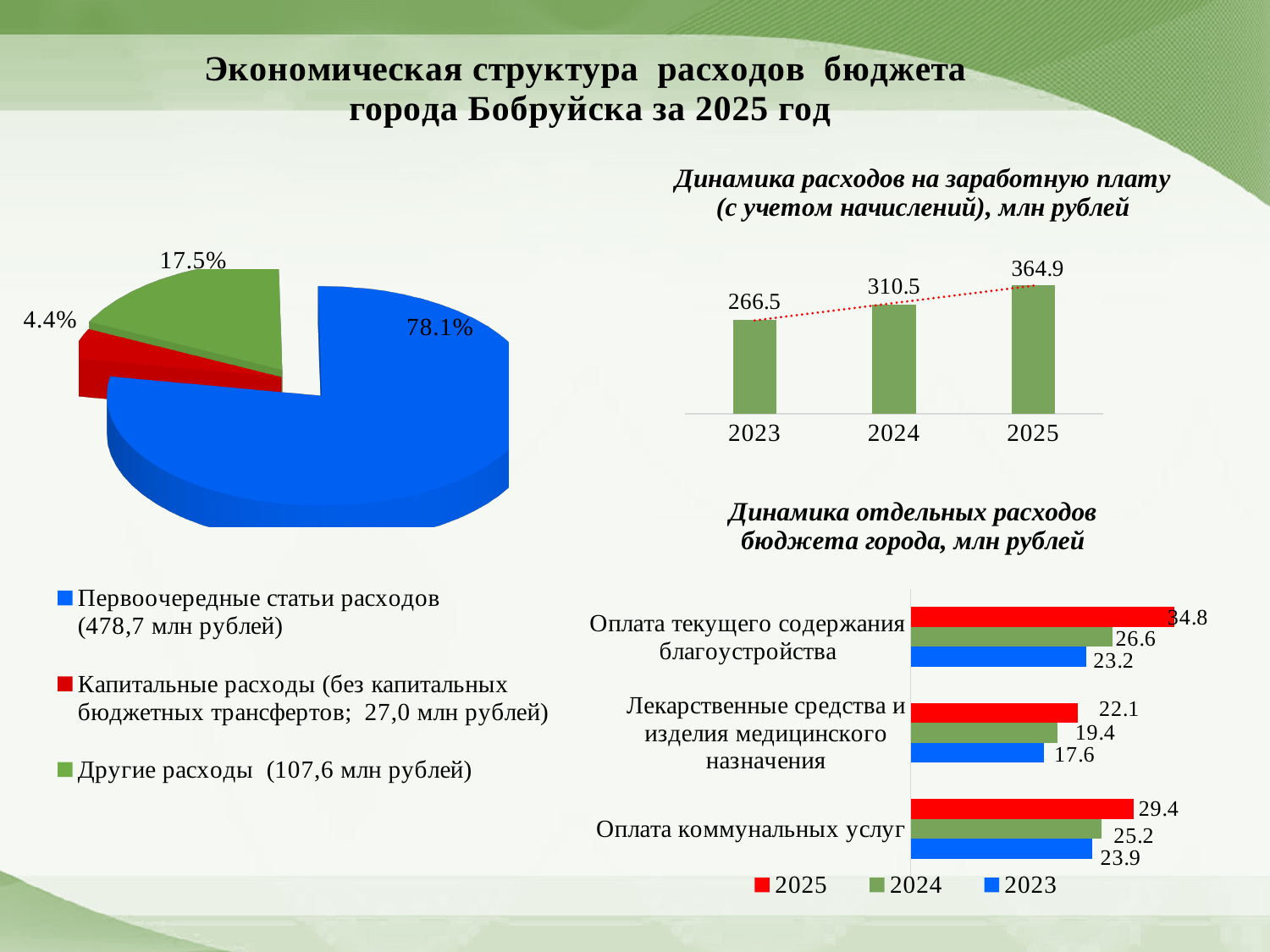
In the pie chart on the left, what share is shown for Первоочередные статьи расходов? 78.1% In the chart 'Динамика расходов на заработную плату', do the values rise or fall from 2023 to 2025? rise In the chart 'Динамика расходов на заработную плату', what is the value for 2024? 310.5 In the chart 'Динамика отдельных расходов бюджета города', what is the 2024 value for Лекарственные средства и изделия медицинского назначения? 19.4 In the chart 'Динамика отдельных расходов бюджета города', how many series does the legend list? 3 In the chart 'Динамика отдельных расходов бюджета города', what is the 2023 value for Оплата коммунальных услуг? 23.9 In the pie chart on the left, how many slices are there? 3 In the chart 'Динамика расходов на заработную плату', what kind of chart is it? bar chart In the chart 'Динамика отдельных расходов бюджета города', which is larger: the 2025 value for Оплата коммунальных услуг or the 2025 value for Лекарственные средства и изделия медицинского назначения? Оплата коммунальных услуг In the pie chart on the left, which category has the smallest slice? Капитальные расходы In the pie chart on the left, what share is shown for Капитальные расходы? 4.4% In the chart 'Динамика расходов на заработную плату', what is the difference between the 2025 and 2023 values? 98.4